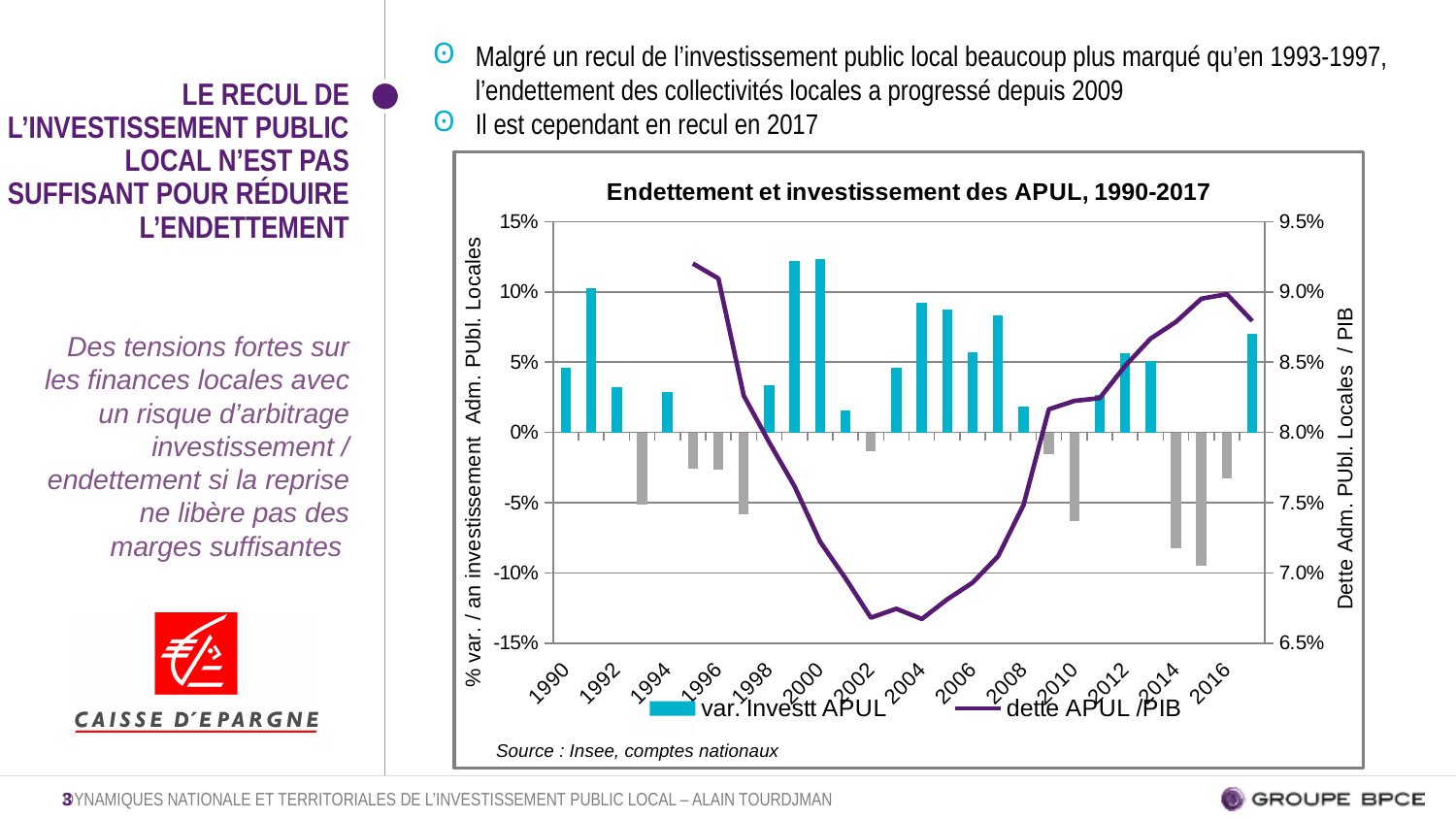
What source is cited below the chart? Insee, comptes nationaux Does dette APUL /PIB rise or fall between 1995 and 2002? fall Is the value of dette APUL /PIB for 2016 greater or less than 8.5%? greater What type of chart is 'Endettement et investissement des APUL, 1990-2017'? A combined bar and line chart Does dette APUL /PIB rise or fall between 2009 and 2016? rise How many series does the legend of the chart list? 2 Is the value of var. Investt APUL for 2017 greater or less than 5%? greater Which year has the larger var. Investt APUL bar, 1999 or 2008? 1999 Is the value of var. Investt APUL for 1991 greater or less than 5%? greater Which series is drawn as a line in the chart? dette APUL /PIB